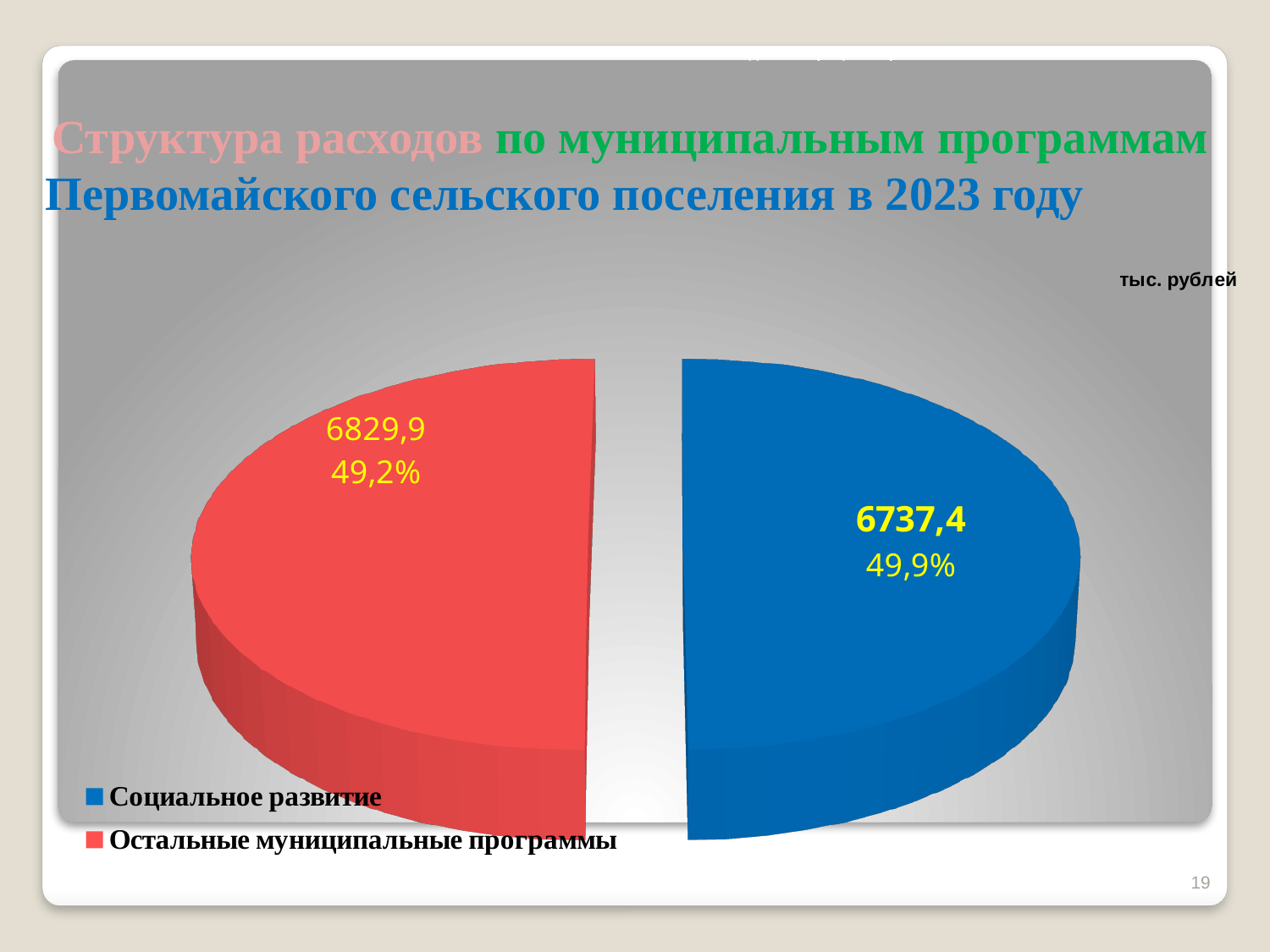
Which category has the lowest value? Социальное развитие How many slices does the pie chart have? 2 What is the value for Остальные муниципальные программы? 6829,9 What colour is the slice for Социальное развитие? blue Which category has the highest value? Остальные муниципальные программы What is the value for Социальное развитие? 6737,4 What kind of chart is shown on the slide? pie chart What unit is indicated for the values on the chart? тыс. рублей What is the difference between the values for Остальные муниципальные программы and Социальное развитие? 92,5 What percentage share is shown for Социальное развитие? 49,9% Which category has the larger value, Социальное развитие or Остальные муниципальные программы? Остальные муниципальные программы What percentage share is shown for Остальные муниципальные программы? 49,2%